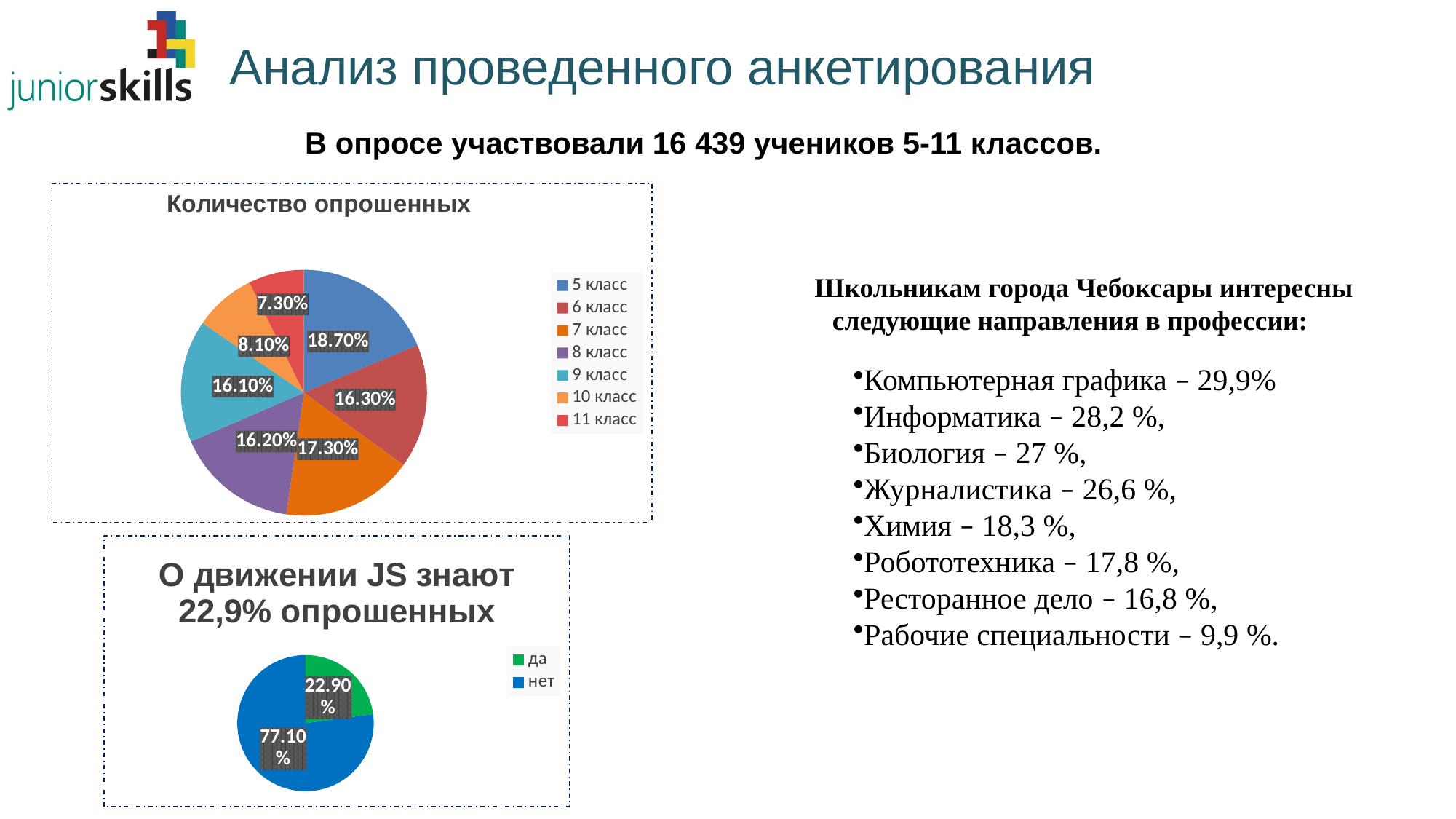
In the chart titled "Количество опрошенных", which class has the largest share? 5 класс What type of chart is the chart titled "Количество опрошенных"? Pie chart How many categories does the legend of the chart titled "Количество опрошенных" list? 7 In the chart titled "О движении JS знают 22,9% опрошенных", what colour is the "да" slice? Green In the chart titled "Количество опрошенных", what share is shown for 5 класс? 18.70% In the chart titled "Количество опрошенных", what is the difference between the shares of 5 класс and 6 класс? 2.40% In the chart titled "Количество опрошенных", which class has the smallest share? 11 класс In the chart titled "О движении JS знают 22,9% опрошенных", what share is shown for "нет"? 77.10% In the chart titled "Количество опрошенных", which has the larger share, 7 класс or 10 класс? 7 класс In the chart titled "Количество опрошенных", what share is shown for 7 класс? 17.30% In the chart titled "Количество опрошенных", what share is shown for 10 класс? 8.10% In the chart titled "О движении JS знают 22,9% опрошенных", what share is shown for "да"? 22.90%